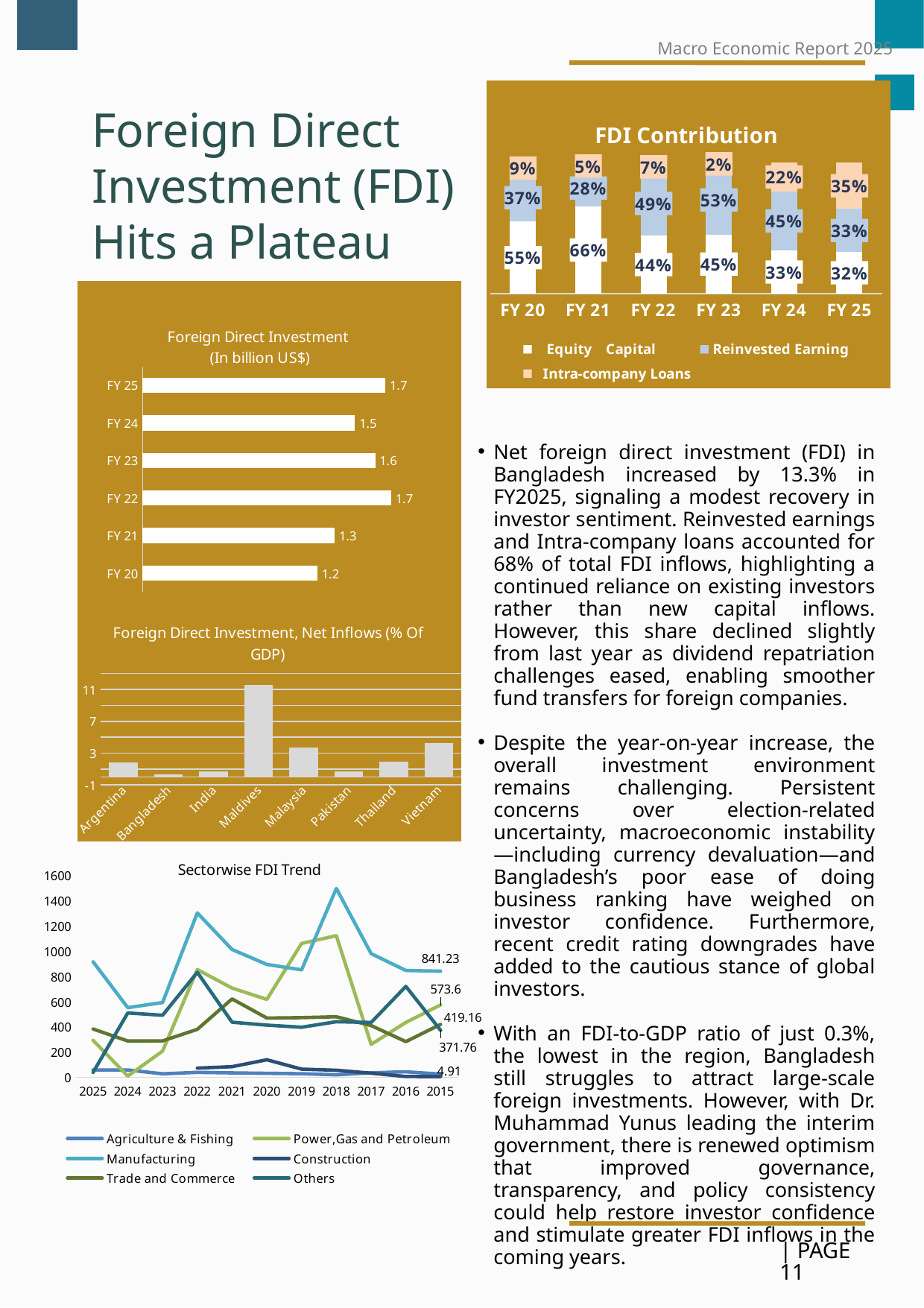
In the Foreign Direct Investment, Net Inflows (% Of GDP) chart, which country has the highest value? Maldives In the FDI Contribution chart, how many series does the legend list? 3 In the FDI Contribution chart, what is the Reinvested Earning share in FY 23? 53% In the Foreign Direct Investment (In billion US$) chart, what is the value for FY 24? 1.5 In the Foreign Direct Investment (In billion US$) chart, what type of chart is used? Bar chart In the Foreign Direct Investment, Net Inflows (% Of GDP) chart, is the value for Maldives greater or less than 7? greater In the Sectorwise FDI Trend chart, what is the Manufacturing value in 2015? 841.23 In the FDI Contribution chart, which fiscal year has the lowest Intra-company Loans share? FY 23 In the Foreign Direct Investment (In billion US$) chart, which fiscal year has the lowest value? FY 20 In the FDI Contribution chart, what is the Equity Capital share in FY 21? 66% In the Foreign Direct Investment (In billion US$) chart, what is the difference between FY 25 and FY 21? 0.4 In the FDI Contribution chart, what is the Intra-company Loans share in FY 25? 35%